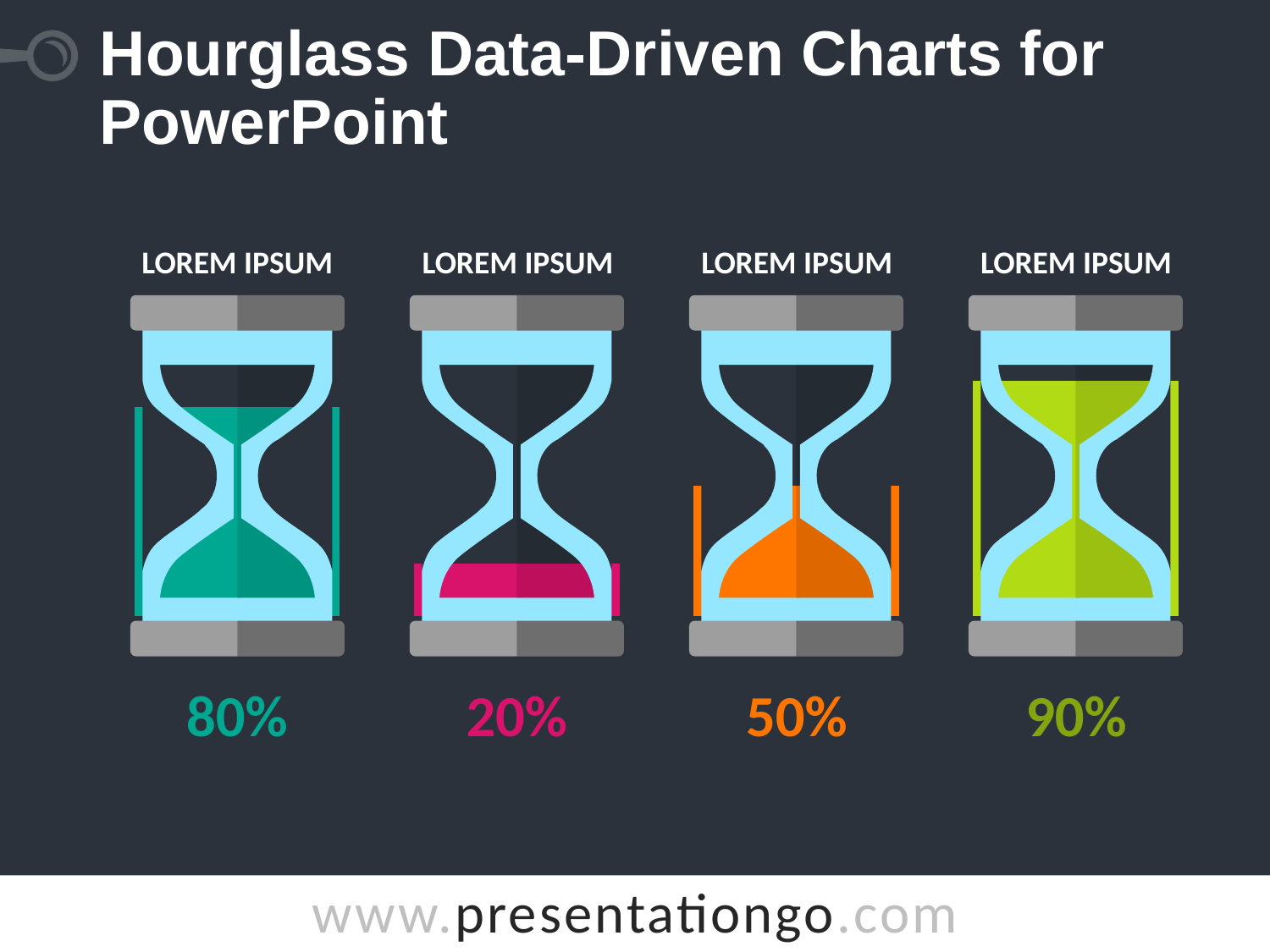
How many hourglass charts are shown on the slide? 4 What colour is the fill of the hourglass showing 50%? Orange What is the difference between the percentages of the rightmost and leftmost hourglasses? 10% Which is larger, the percentage of the third hourglass or the second hourglass? The third hourglass (50%) Which hourglass shows the lowest percentage? The second hourglass, 20% What percentage is shown under the third hourglass from the left? 50% What percentage is shown under the second hourglass from the left? 20% What percentage is shown under the fourth (rightmost) hourglass? 90% What percentage is shown under the first (leftmost) hourglass? 80% What is the title of the slide? Hourglass Data-Driven Charts for PowerPoint What is the difference between the percentages of the first and second hourglasses? 60% Which hourglass shows the highest percentage? The fourth (rightmost) hourglass, 90%